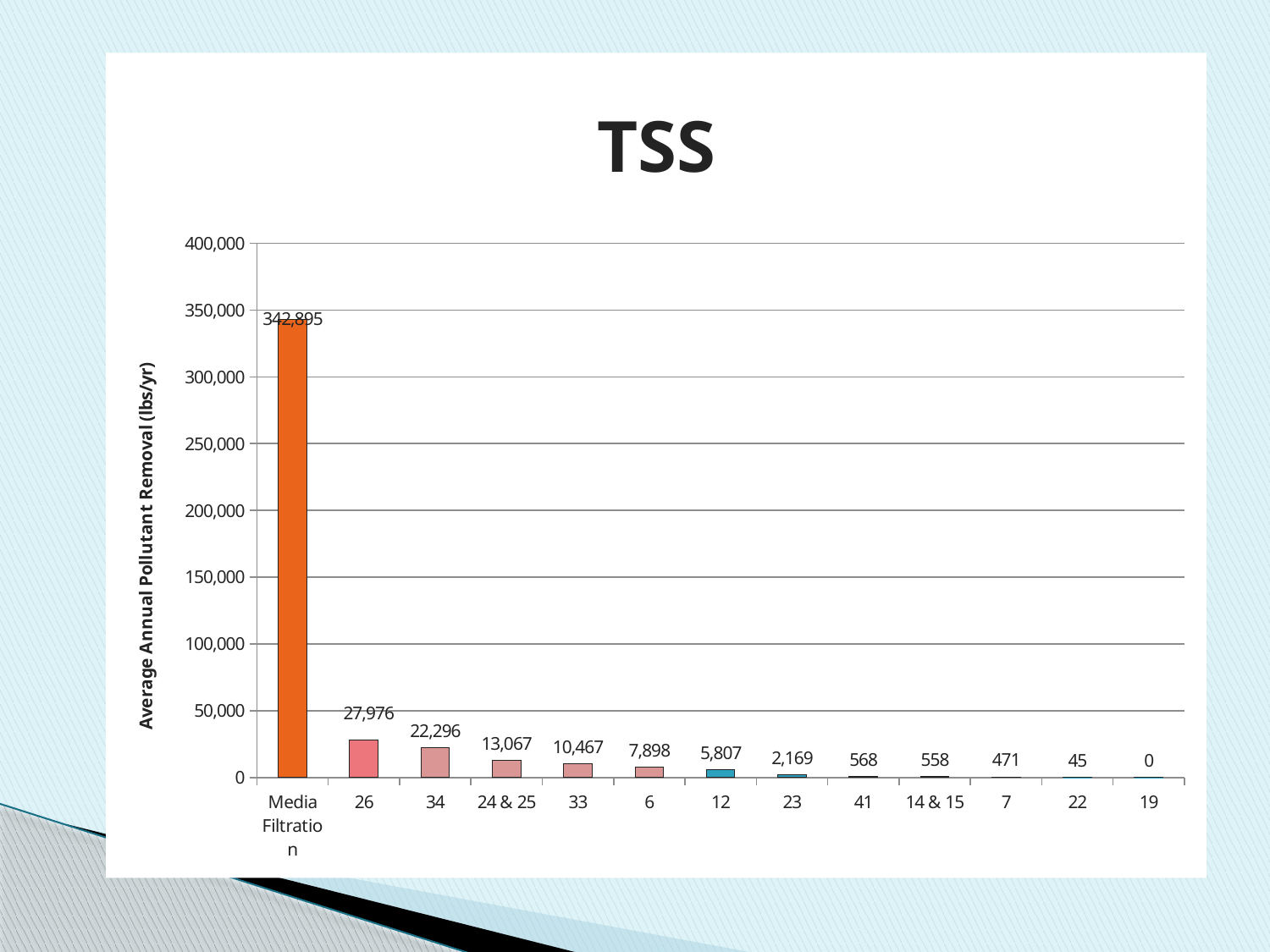
What is the value for category 26? 27,976 Which is larger, the value for category 33 or the value for category 6? 33 Which category has the lowest value? 19 How many categories are shown on the x axis? 13 What is the value for category 24 & 25? 13,067 What is the y-axis label of the chart? Average Annual Pollutant Removal (lbs/yr) What is the difference between the values for category 26 and category 34? 5,680 Is the value for Media Filtration greater or less than 300,000? greater What kind of chart is this? bar chart What is the value for category 14 & 15? 558 What is the value for Media Filtration? 342,895 Which category has the highest value? Media Filtration